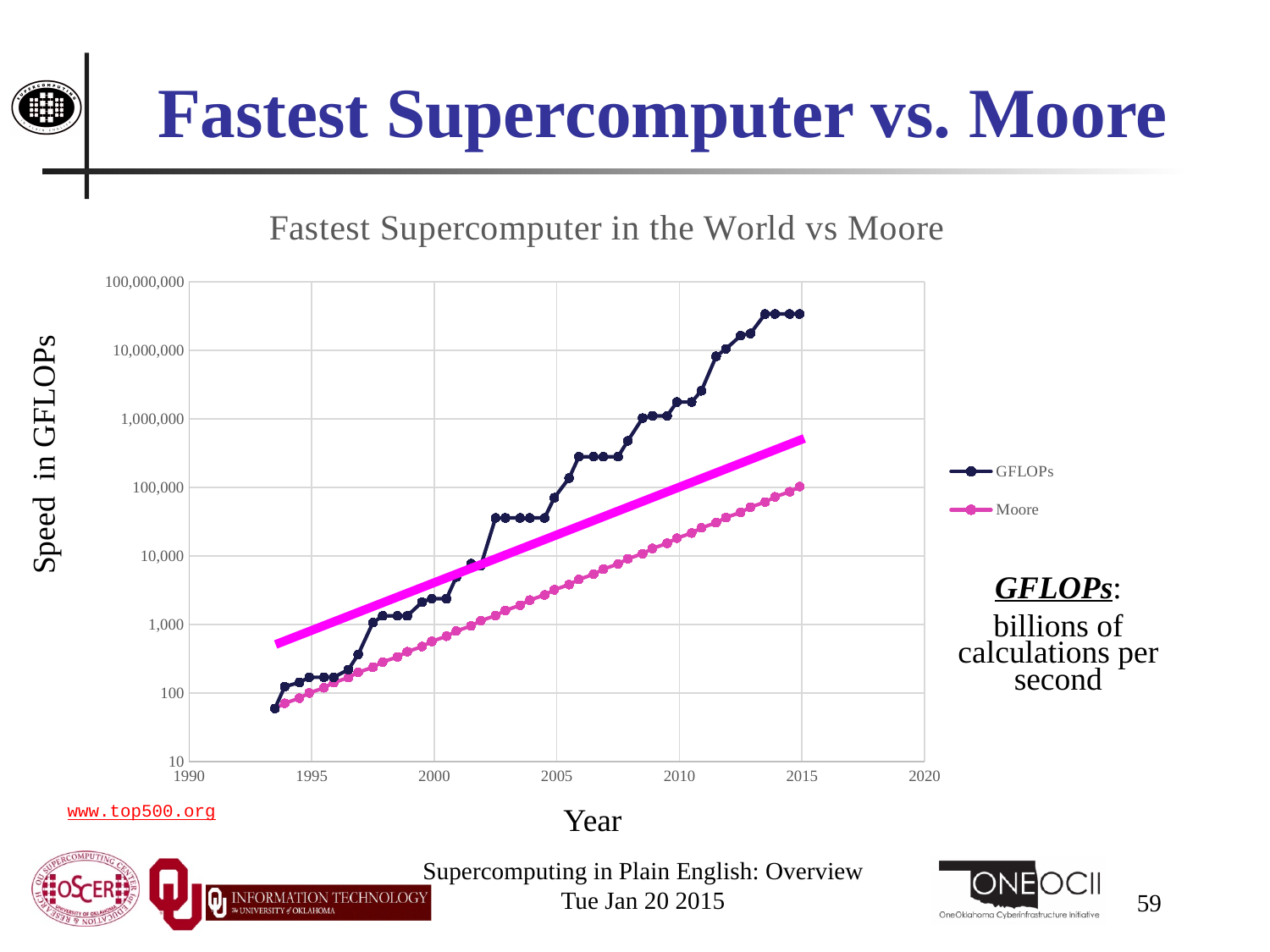
Do the GFLOPs values rise or fall as the year increases? rise In 2010, which series has the larger value, GFLOPs or Moore? GFLOPs What is the title of the chart? Fastest Supercomputer in the World vs Moore How many series does the chart's legend list? 2 What kind of chart is shown on the slide? line chart Is the Moore value in 2005 greater or less than 10,000? less In 2015, which series has the larger value, GFLOPs or Moore? GFLOPs What are the two series named in the legend? GFLOPs and Moore Is the GFLOPs value in 2015 greater or less than 10,000,000? greater Is the Moore value in 2010 greater or less than 10,000? greater